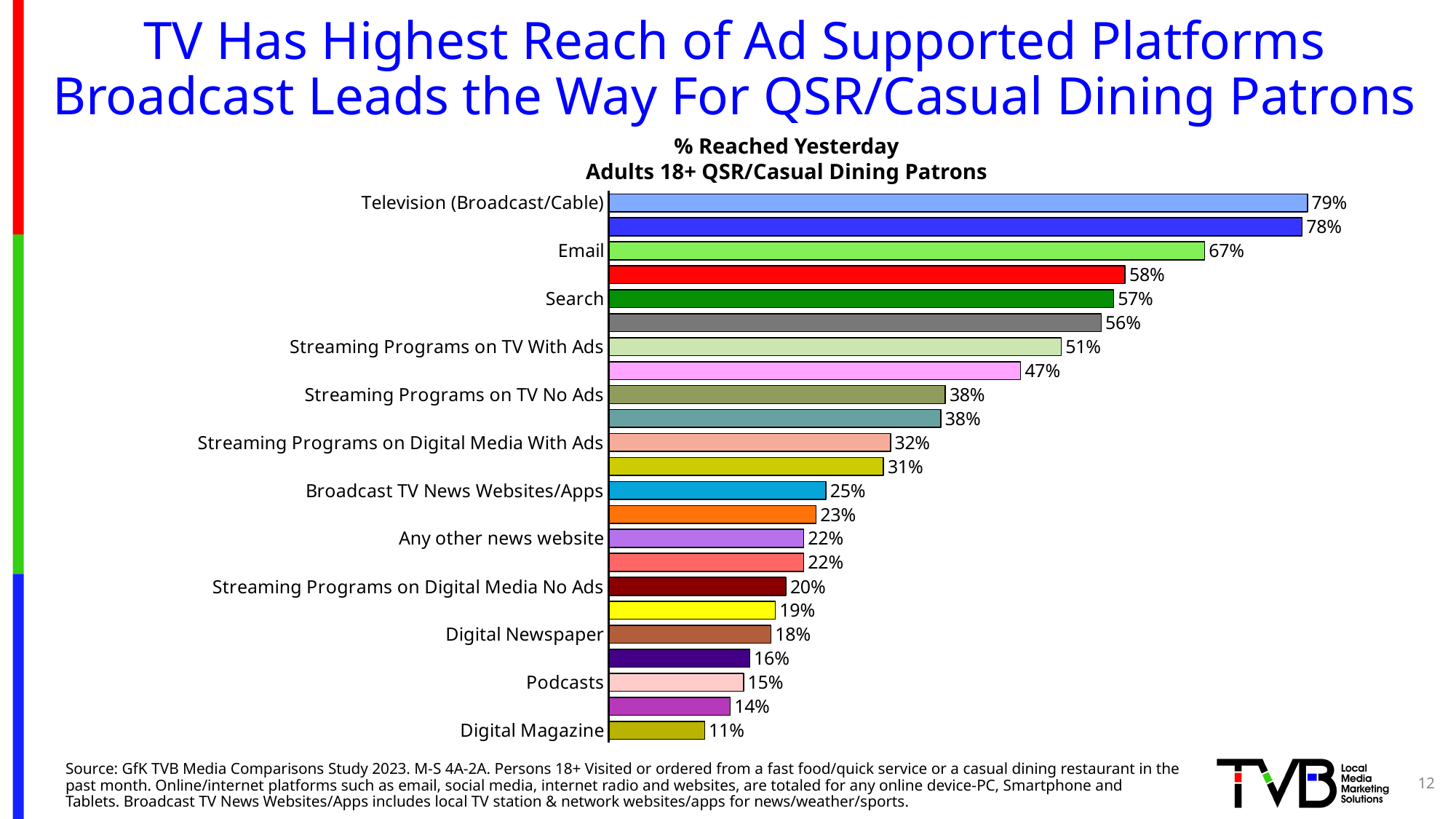
Which platform has the highest % reached yesterday? Television (Broadcast/Cable) How many bars are plotted in the chart? 23 What is the difference in % reached yesterday between Broadcast TV News Websites/Apps and Digital Newspaper? 7% What type of chart is shown on the slide? Bar chart What is the % reached yesterday for Streaming Programs on TV With Ads? 51% What is the % reached yesterday for Email? 67% Which platform has the lowest % reached yesterday? Digital Magazine What is the difference in % reached yesterday between Email and Search? 10% What is the % reached yesterday for Podcasts? 15% What is the % reached yesterday for Television (Broadcast/Cable)? 79% What is the subtitle of the chart describing the audience measured? Adults 18+ QSR/Casual Dining Patrons Which has a higher % reached yesterday, Streaming Programs on TV No Ads or Streaming Programs on Digital Media With Ads? Streaming Programs on TV No Ads